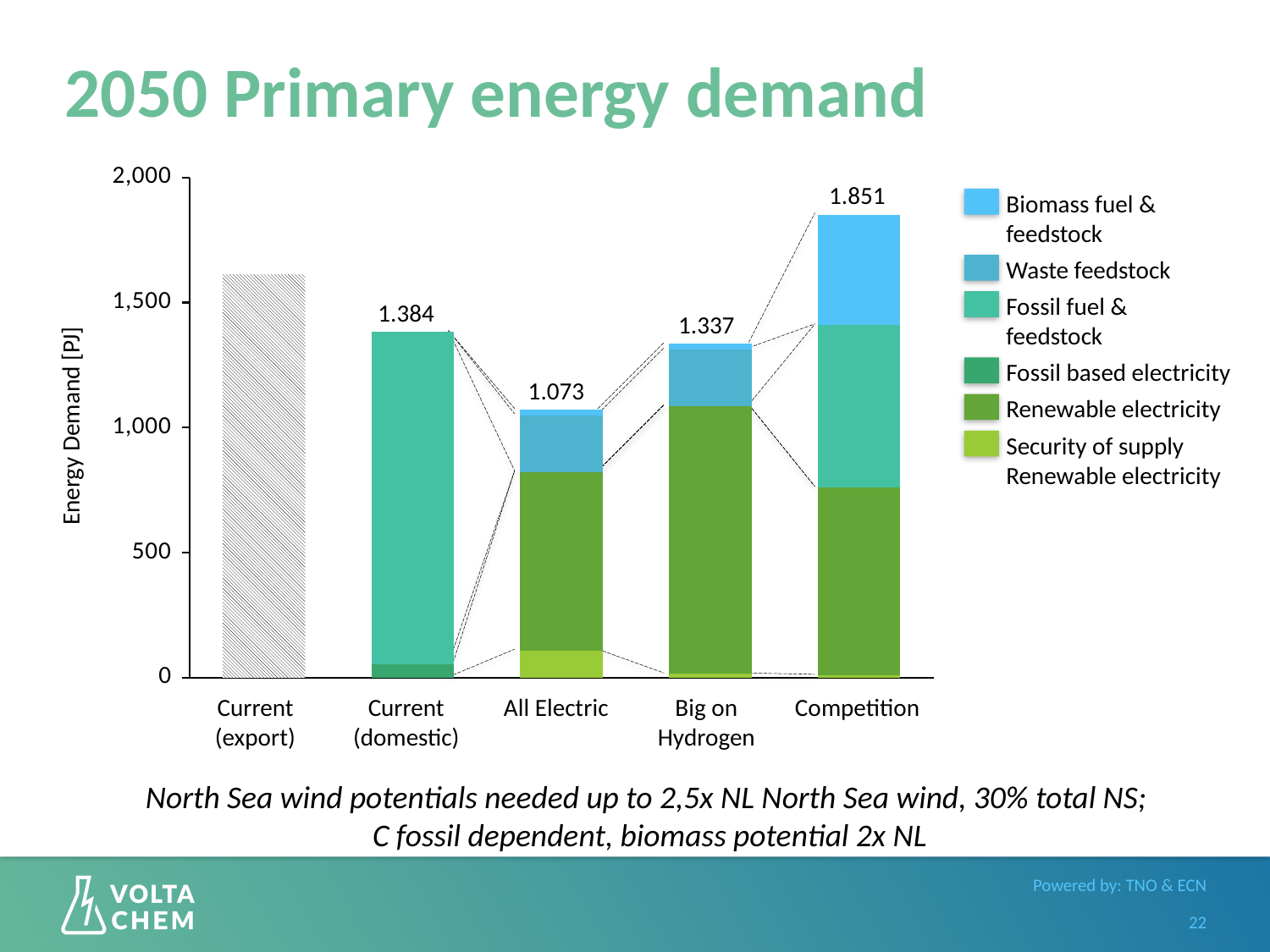
What is the total value labelled on the Current (domestic) bar? 1.384 What is the total energy demand shown for the Competition scenario? 1.851 Which has a larger labelled total, Current (domestic) or Big on Hydrogen? Current (domestic) Which scenario has the lowest total energy demand? All Electric What is the label on the y axis? Energy Demand [PJ] What is the total value labelled on the Big on Hydrogen bar? 1.337 What is the difference between the labelled totals for Competition and All Electric? 778 How many series does the legend list? 6 How many categories are shown on the x axis? 5 Is the value for Current (export) greater or less than 1,500? greater Which scenario has the highest total energy demand? Competition What is the total value labelled on the All Electric bar? 1.073